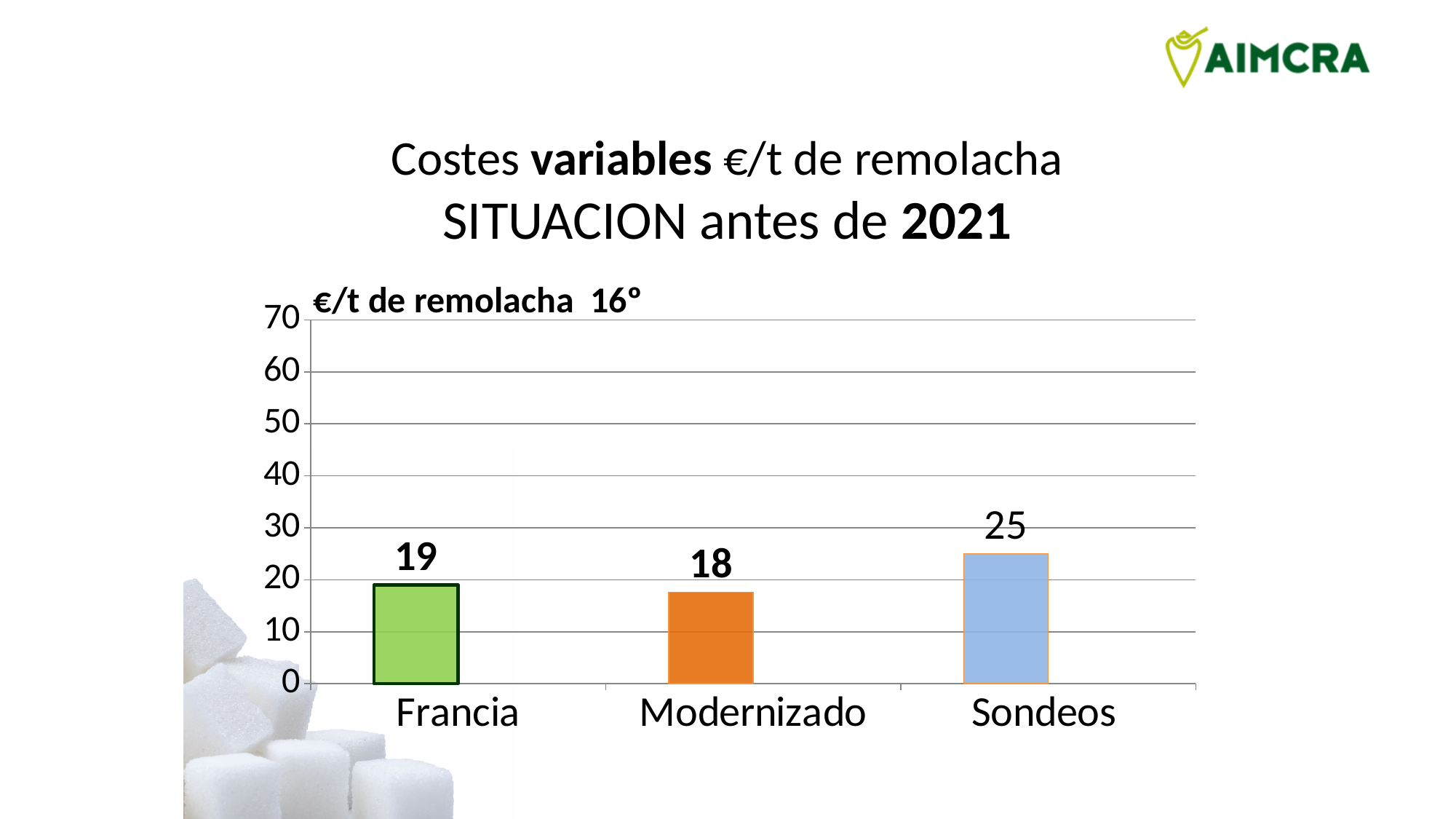
What is the value for Francia? 19 Is the value for Sondeos greater or less than 30? less Which category has the highest value? Sondeos Which category has the lowest value? Modernizado What is the difference between the values for Sondeos and Francia? 6 What is the value for Sondeos? 25 How many categories are shown on the x axis? 3 Which is larger, the value for Sondeos or the value for Modernizado? Sondeos What is the value for Modernizado? 18 What kind of chart is shown on the slide? bar chart What is the label shown at the top of the chart's vertical axis? €/t de remolacha 16° What is the difference between the values for Sondeos and Modernizado? 7